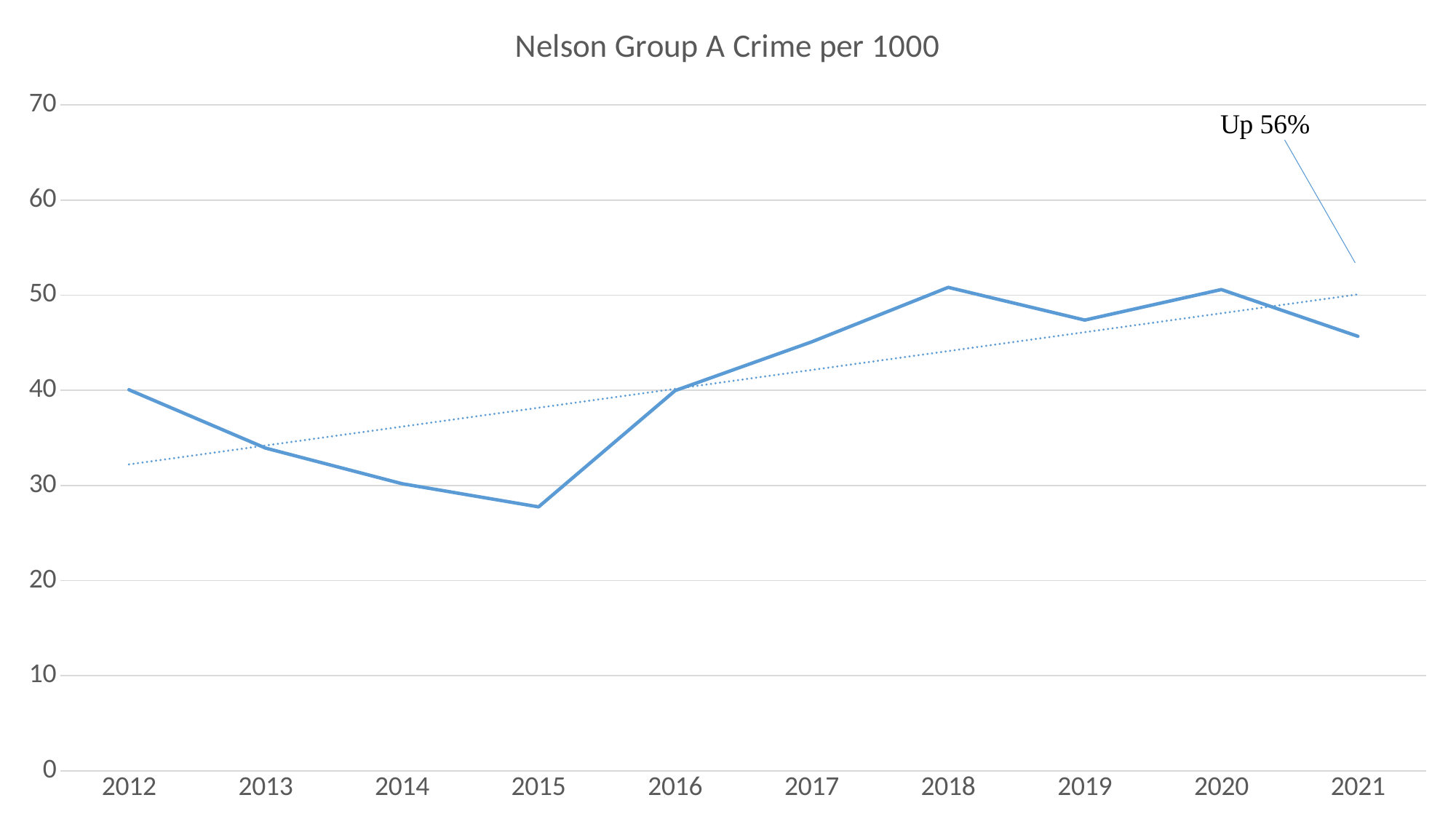
Which is higher, the value for 2012 or the value for 2015? 2012 Is the value for 2018 greater or less than 50? greater Is the value for 2021 greater or less than 50? less How many years are plotted along the x axis? 10 What type of chart is shown on the slide? line chart Is the value for 2015 greater or less than 30? less Which is higher, the value for 2019 or the value for 2014? 2019 Do the values rise or fall from 2012 to 2015? fall What is the title of the chart? Nelson Group A Crime per 1000 What percentage change does the annotation on the chart state? Up 56% Which year has the lowest crime rate per 1000? 2015